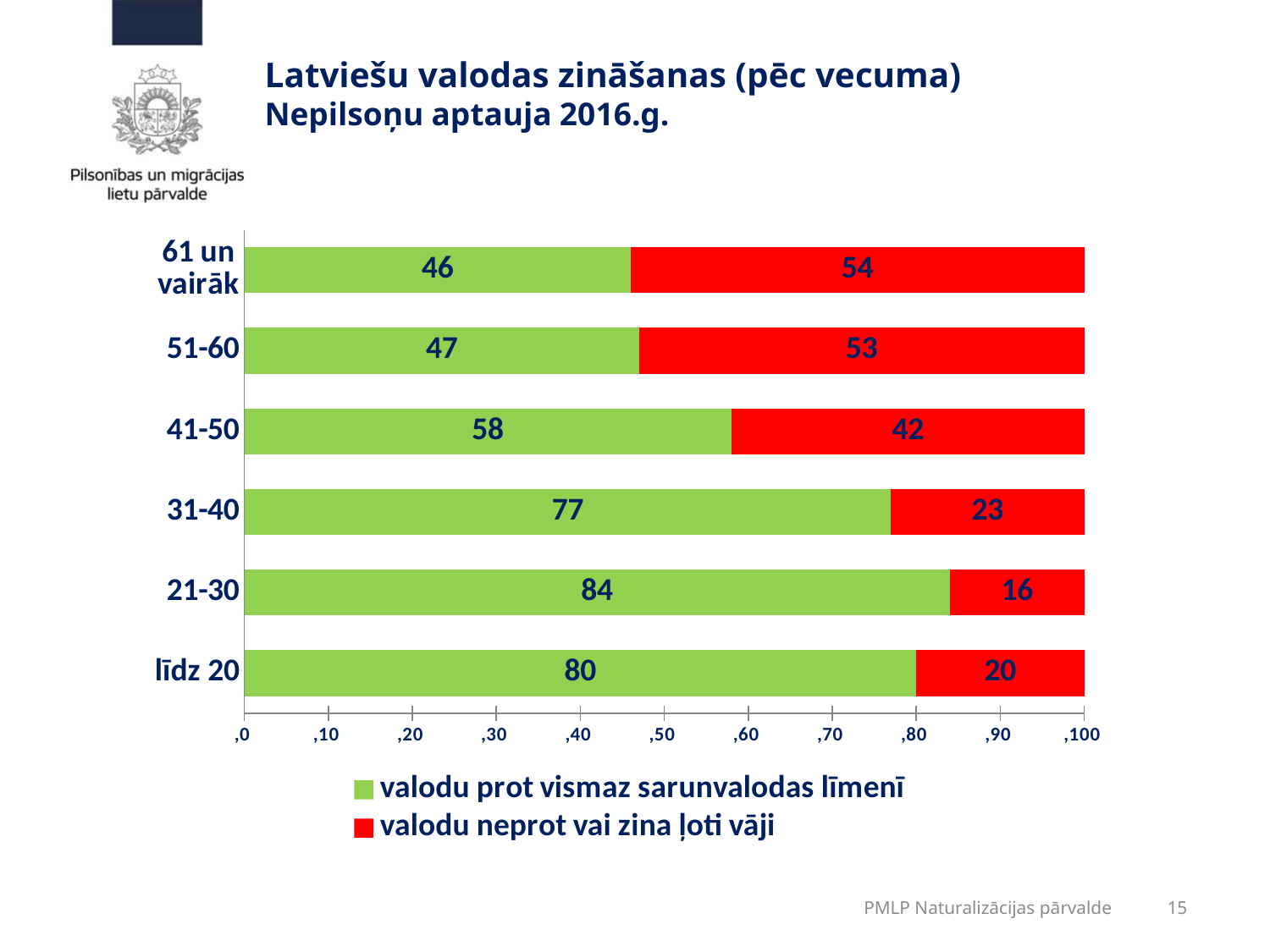
What kind of chart is shown on the slide? stacked bar chart Which is larger: the 'valodu neprot vai zina ļoti vāji' value for līdz 20 or for 21-30? līdz 20 How many age groups are shown on the chart? 6 Which age group has the highest value for 'valodu prot vismaz sarunvalodas līmenī'? 21-30 Which age group has the lowest value for 'valodu neprot vai zina ļoti vāji'? 21-30 How many series does the legend list? 2 What is the value for 'valodu neprot vai zina ļoti vāji' in the 61 un vairāk age group? 54 What is the value for 'valodu prot vismaz sarunvalodas līmenī' in the 41-50 age group? 58 What is the value for 'valodu prot vismaz sarunvalodas līmenī' in the 21-30 age group? 84 What is the total of the stacked bar for the 51-60 age group? 100 Which colour represents 'valodu neprot vai zina ļoti vāji' in the chart? red What is the difference between the 'valodu prot vismaz sarunvalodas līmenī' values for 31-40 and 41-50? 19